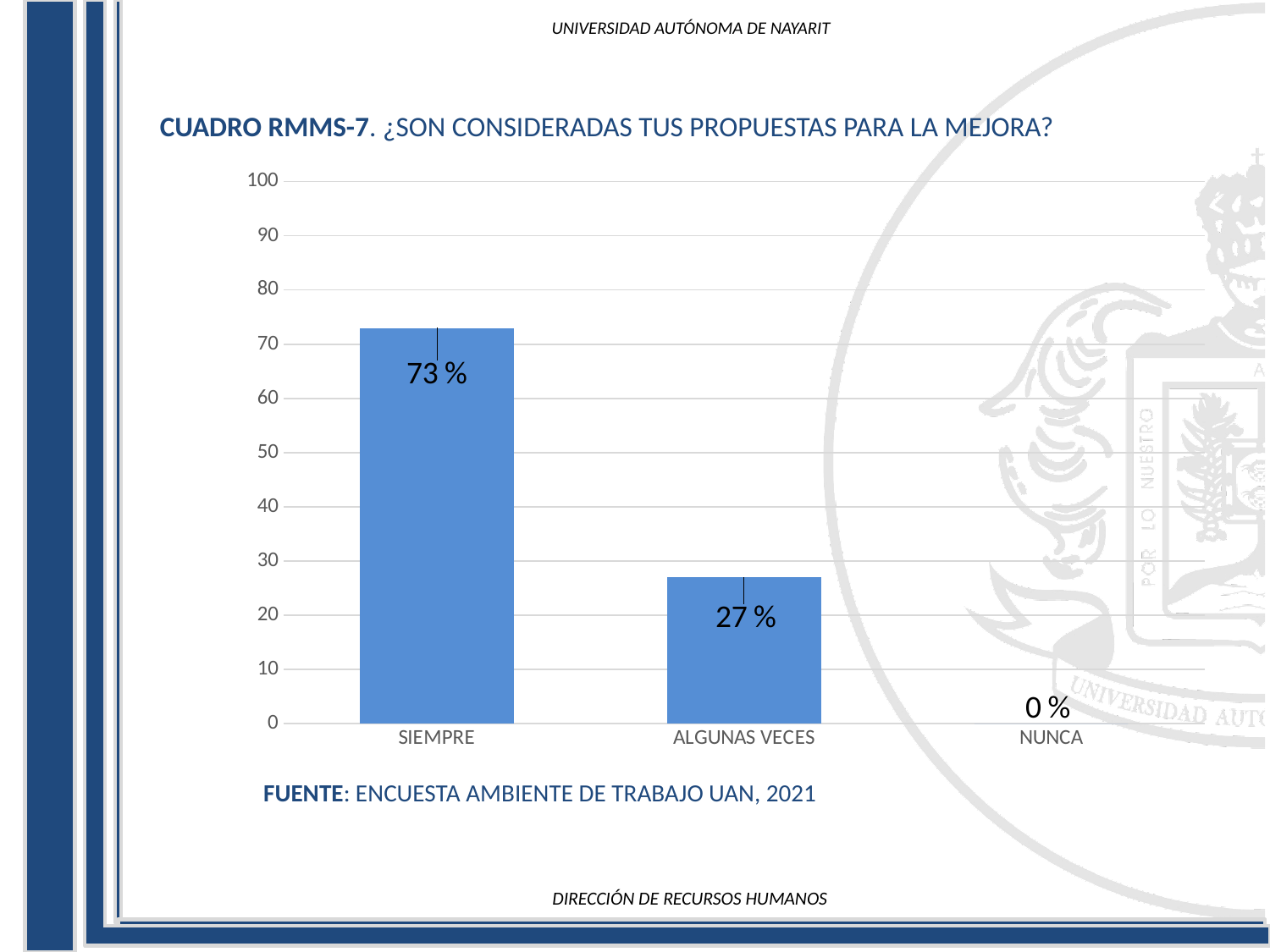
Which is larger, the value for SIEMPRE or the value for ALGUNAS VECES? SIEMPRE What is the value for NUNCA? 0 % What kind of chart is shown on the slide? bar chart What is the value for ALGUNAS VECES? 27 % Is the value for SIEMPRE greater or less than 50? greater How many categories are shown on the x axis? 3 What is the source cited below the chart? ENCUESTA AMBIENTE DE TRABAJO UAN, 2021 Which category has the lowest value? NUNCA What is the value for SIEMPRE? 73 % What is the difference between the values for SIEMPRE and ALGUNAS VECES? 46 % Which category has the highest value? SIEMPRE Is the value for ALGUNAS VECES greater or less than 30? less